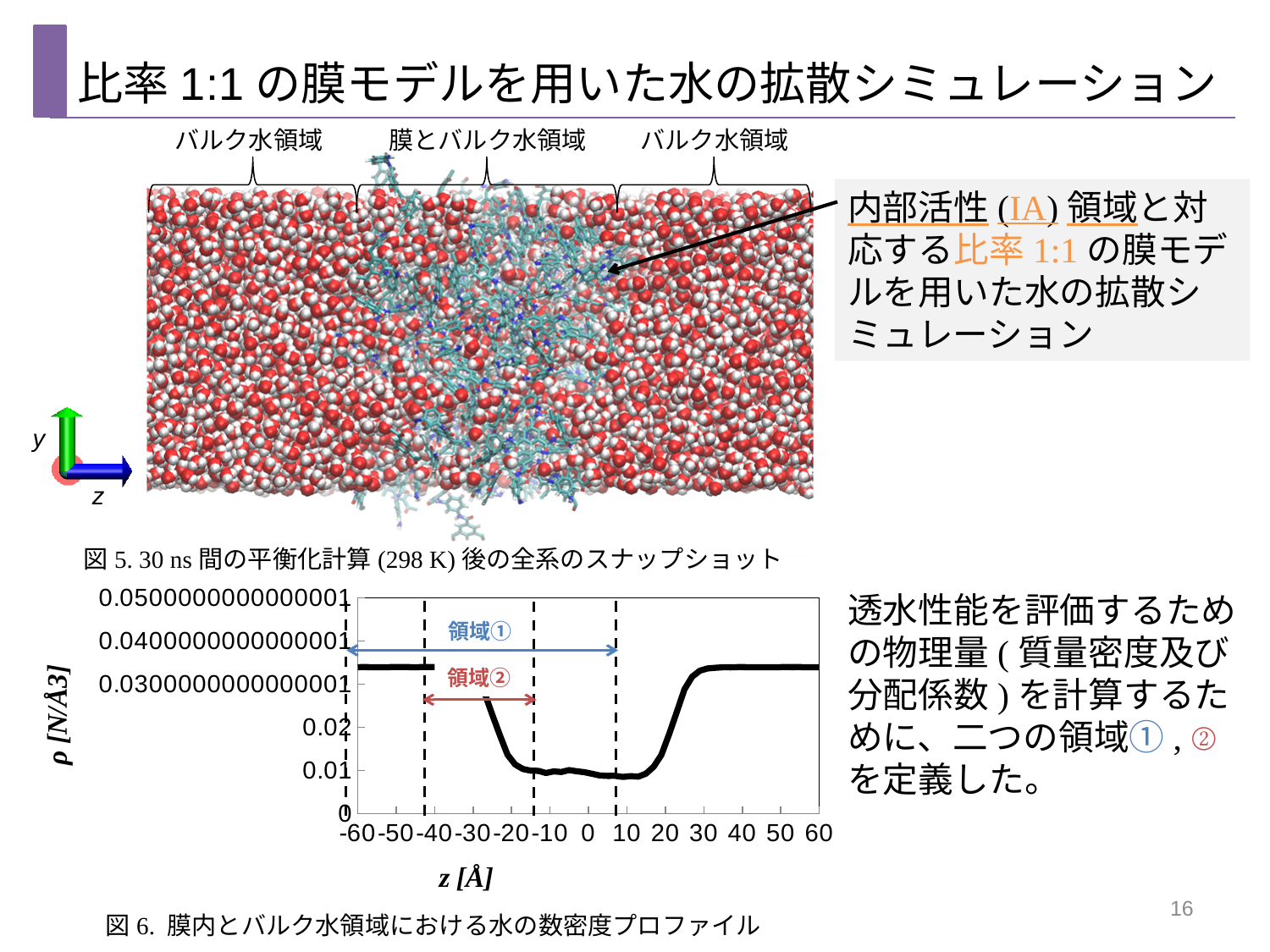
In the chart 図 6, is the value at z = -60 greater or less than 0.03? greater In the chart 図 6, is the value at z = 0 greater or less than 0.02? less In the chart 図 6, which is larger, the value at z = 50 or the value at z = -10? z = 50 In the chart 図 6, what is the label of the x axis? z [Å] In the chart 図 6, what is the label of the y axis? ρ [N/Å3] In the chart 図 6, is the value at z = 60 greater or less than 0.03? greater What kind of chart is shown at the bottom of the slide (図 6)? line chart In the chart 図 6, do the values rise or fall as z goes from 10 to 30? rise In the chart 図 6, which is larger, the value at z = -60 or the value at z = 0? z = -60 In the chart 図 6, do the values rise or fall as z goes from -30 to -10? fall In the chart 図 6, how many plotted lines (series) are shown? 1